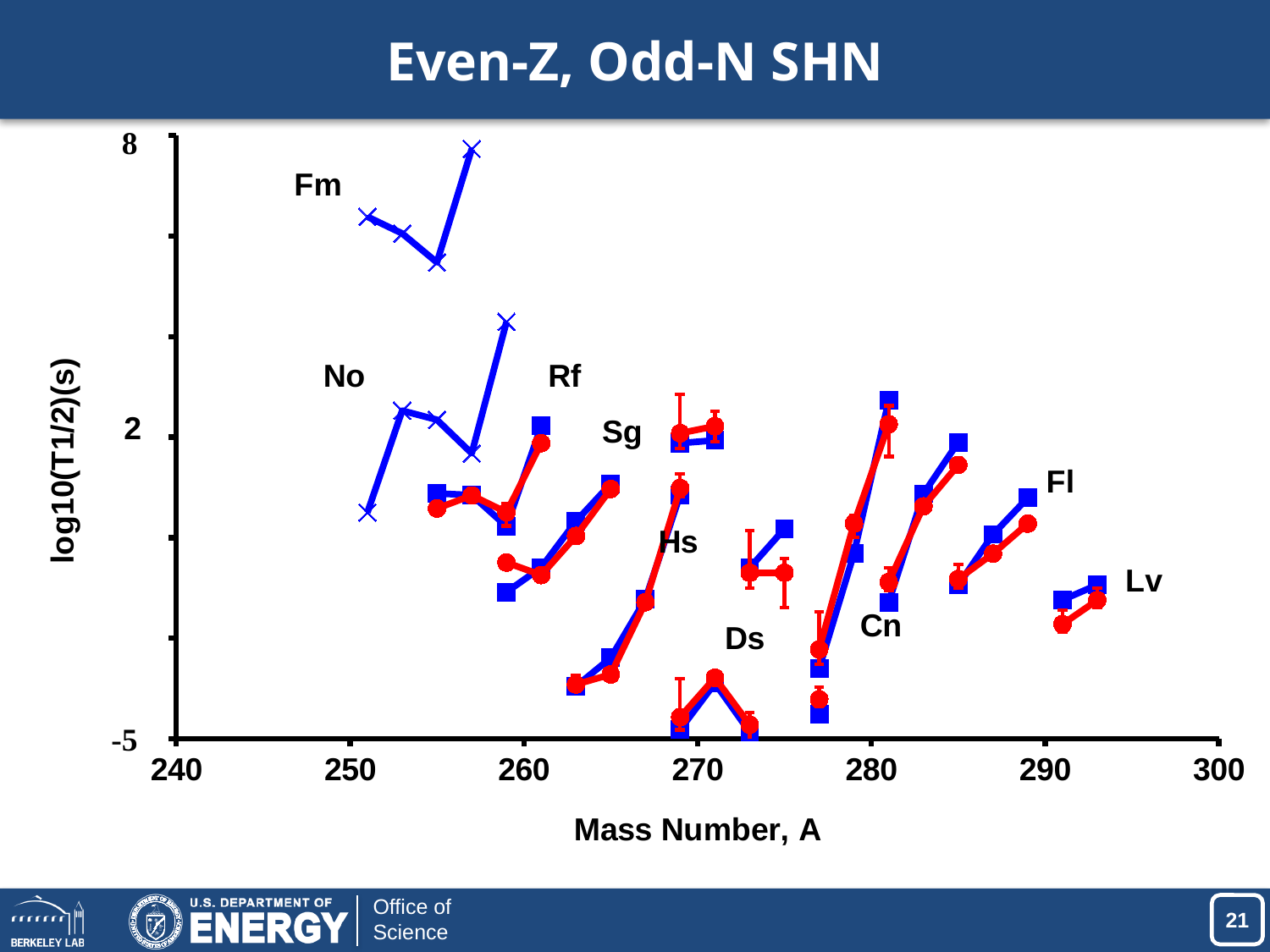
Do the Fm values rise or fall as the mass number increases from 251 to 255? fall Is the No value at mass number 259 greater or less than 2? greater Is the Fm value at mass number 257 greater or less than 2? greater What kind of chart is shown on the slide? line chart How many element labels (Fm, No, Rf, etc.) are shown on the chart? 9 Which is larger, the Fm value at mass number 257 or the Lv value at mass number 293? Fm at 257 Is the Ds value at mass number 273 greater or less than 2? less What two colours are used for the plotted series? blue and red Which element's data reaches the highest log10(T1/2) value on the chart? Fm What is the title of the x axis? Mass Number, A Do the Hs values rise or fall as the mass number increases from 263 to 269? rise